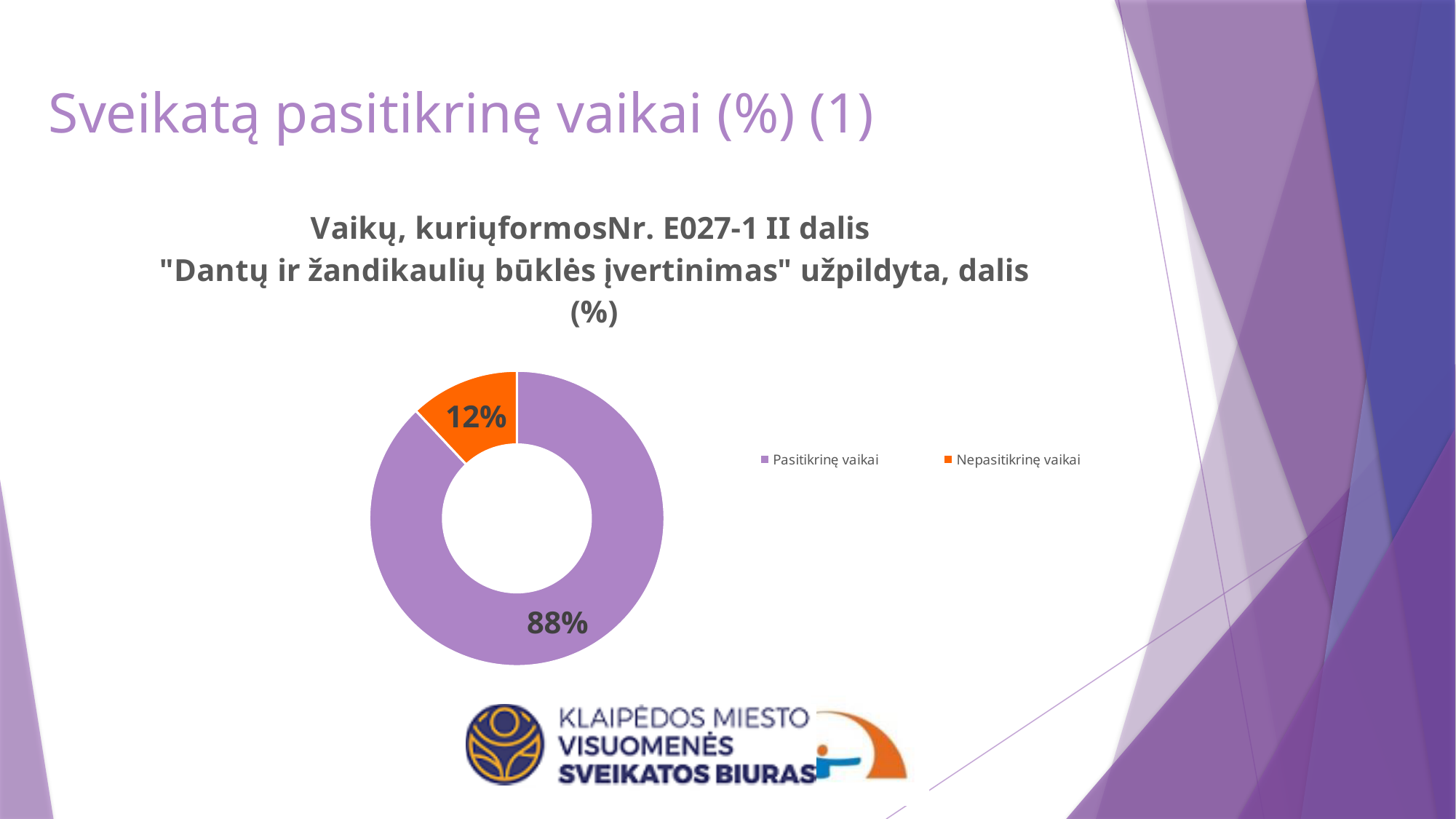
How many categories does the chart show? 2 Which category has the largest share of the chart? Pasitikrinę vaikai What is the difference in percentage points between Pasitikrinę vaikai and Nepasitikrinę vaikai? 76 What colour is the Pasitikrinę vaikai slice? Purple What percentage is shown for Pasitikrinę vaikai? 88% Which is larger, the share for Pasitikrinę vaikai or for Nepasitikrinę vaikai? Pasitikrinę vaikai What kind of chart is shown on the slide? Doughnut (pie) chart Which category has the smallest share of the chart? Nepasitikrinę vaikai What colour is the Nepasitikrinę vaikai slice? Orange How many entries does the legend list? 2 What percentage is shown for Nepasitikrinę vaikai? 12% What share of the chart does the Nepasitikrinę vaikai slice represent? 12%